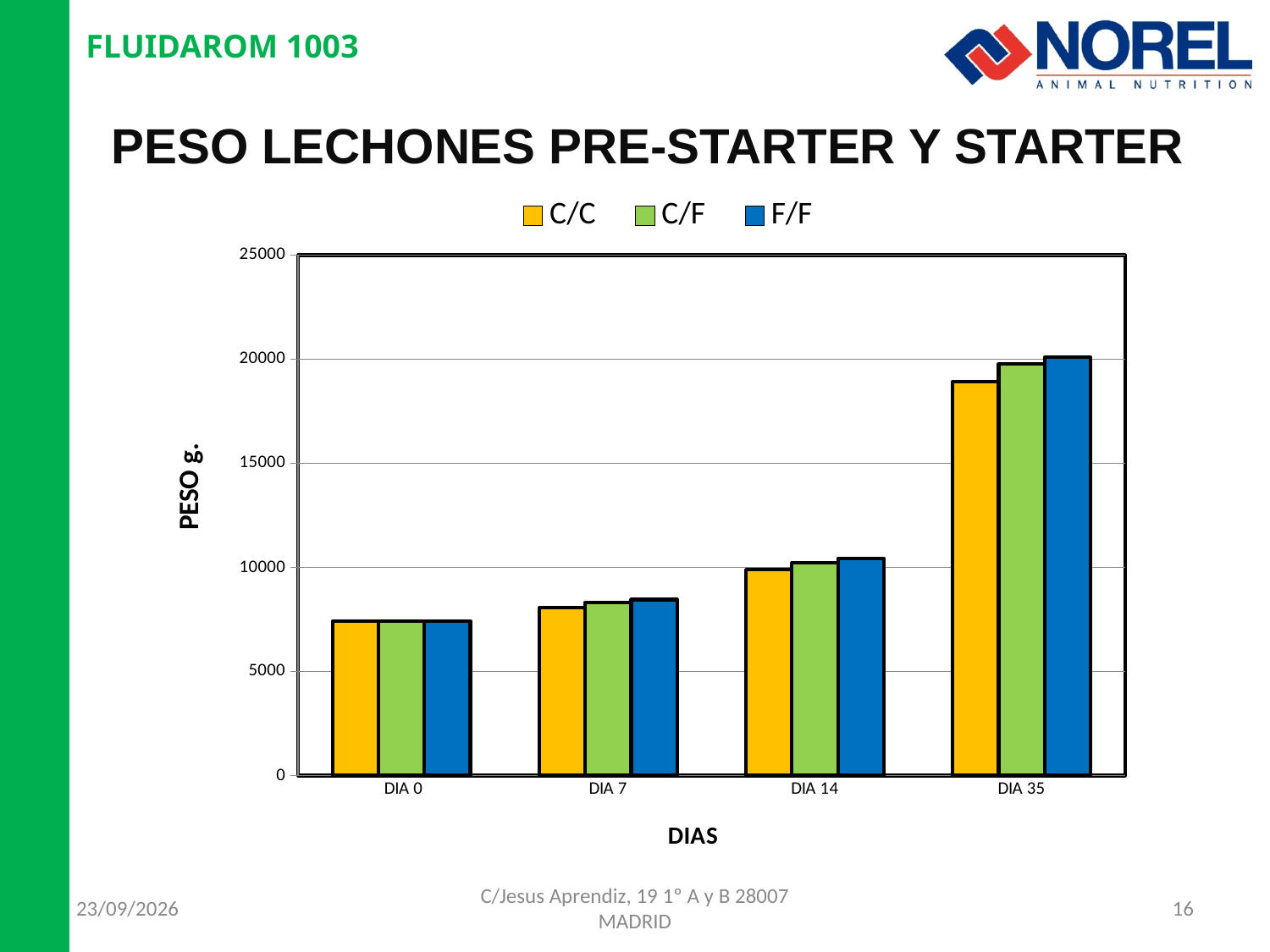
What kind of chart is shown on the slide? bar chart What is the title of the y axis? PESO g. Which day category has the highest F/F value? DIA 35 How many day categories are shown on the x axis? 4 Is the C/F value at DIA 35 greater or less than 15000? greater How many series does the legend list? 3 Do the C/F values rise or fall from DIA 0 to DIA 35? rise Is the C/C value at DIA 7 greater or less than 10000? less At DIA 35, which is larger, the C/C value or the F/F value? F/F Is the F/F value at DIA 0 greater or less than 5000? greater Which day category has the lowest C/C value? DIA 0